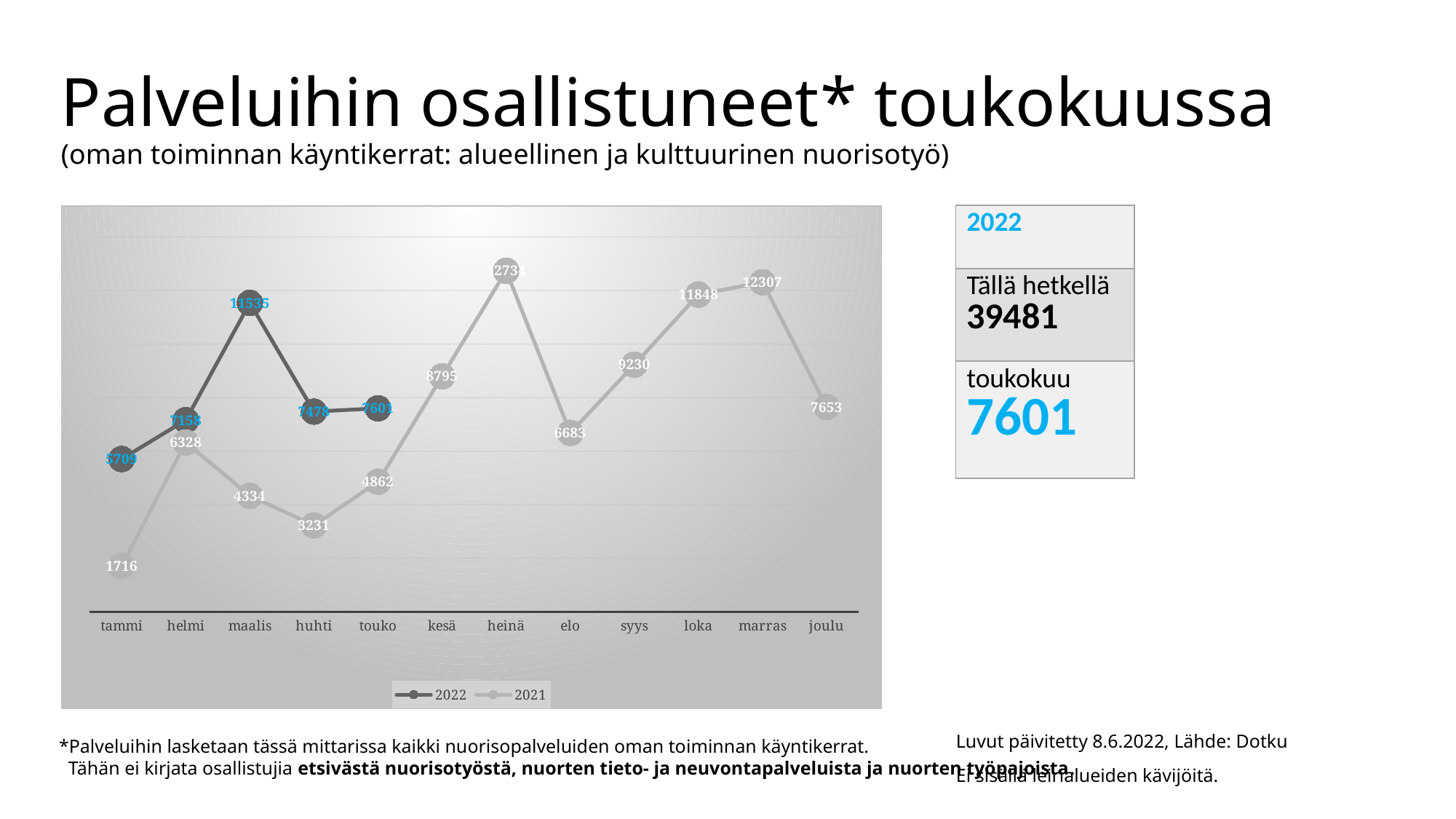
What kind of chart is shown on the slide? line chart How many series does the chart legend list? 2 What is the value for touko in the 2022 series? 7601 What is the value for joulu in the 2021 series? 7653 Which series has the larger value for helmi, 2022 or 2021? 2022 What is the difference between the 2022 and 2021 values for touko? 2739 What is the value for heinä in the 2021 series? 12734 How many months are shown on the x axis? 12 Does the 2021 series rise or fall from tammi to helmi? rise Which month has the lowest value in the 2021 series? tammi Which month has the highest value in the 2022 series? maalis Which month has the highest value in the 2021 series? heinä